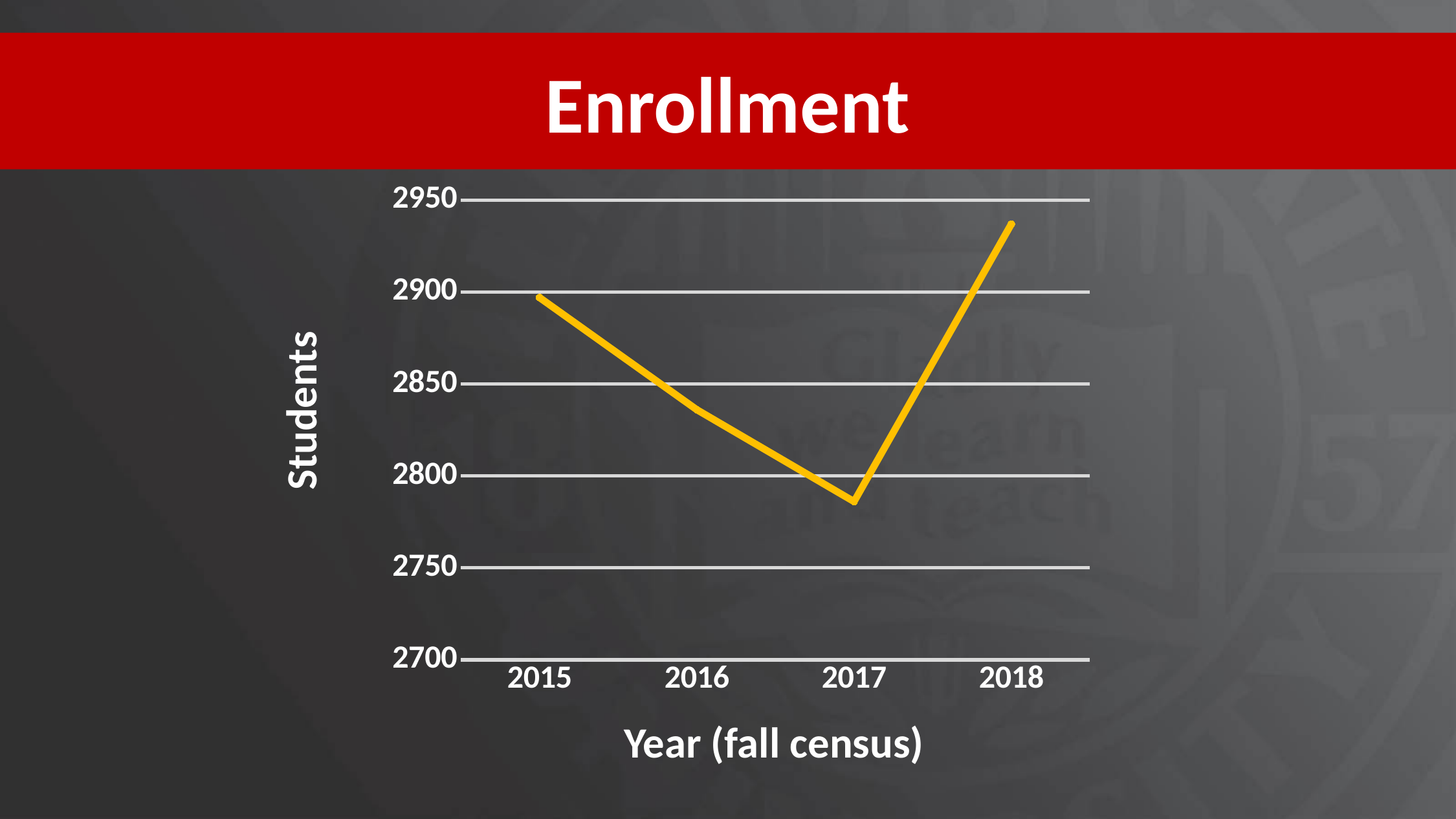
What kind of chart is shown on the slide? Line chart Which year has the lowest enrollment? 2017 What is the label on the x axis of the chart? Year (fall census) How many years (data points) are plotted on the chart? 4 What is the title of the chart? Enrollment Is the enrollment for 2016 greater or less than 2800? greater Is the enrollment for 2016 greater or less than 2850? less Is the enrollment for 2017 greater or less than 2800? less Which year has the highest enrollment? 2018 How does enrollment change from 2015 to 2017? It falls Which year has higher enrollment, 2015 or 2016? 2015